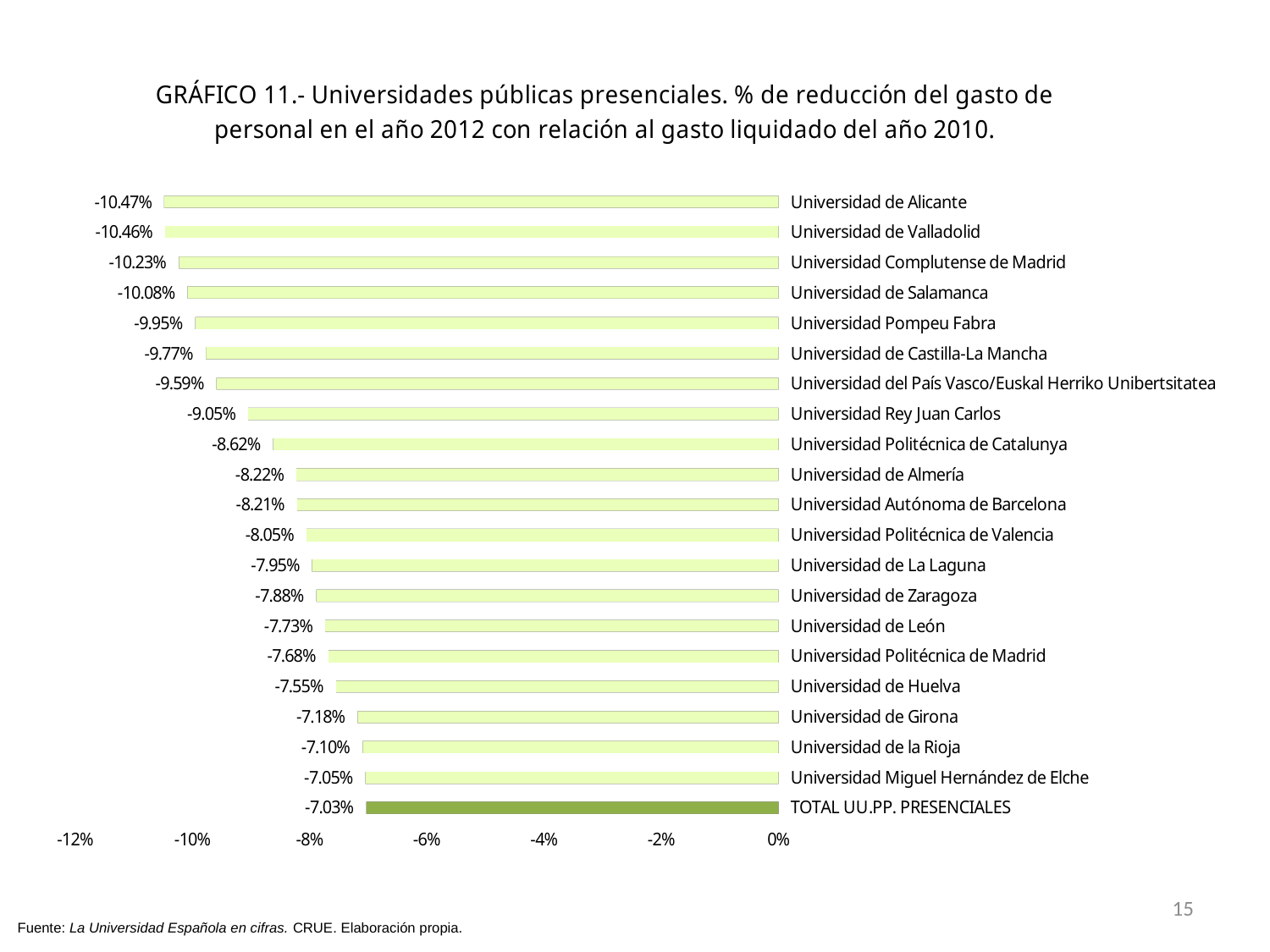
What is the difference in percentage points between the values for Universidad de Alicante and Universidad de Zaragoza? 2.59 percentage points Which bar is shown in a darker green colour than the others? TOTAL UU.PP. PRESENCIALES What is the value shown for Universidad de Zaragoza? -7.88% How many bars are plotted in the chart? 21 Is the value for Universidad Rey Juan Carlos greater or less than -8%? less What type of chart is shown on the slide? Bar chart Which has a larger reduction in personnel spending, Universidad de Salamanca or Universidad de Huelva? Universidad de Salamanca Which category has the smallest percentage reduction (the value closest to 0%)? TOTAL UU.PP. PRESENCIALES Which category has the largest percentage reduction (the most negative value)? Universidad de Alicante What is the value shown for Universidad de Alicante? -10.47% What is the value shown for TOTAL UU.PP. PRESENCIALES? -7.03% What is the value shown for Universidad del País Vasco/Euskal Herriko Unibertsitatea? -9.59%